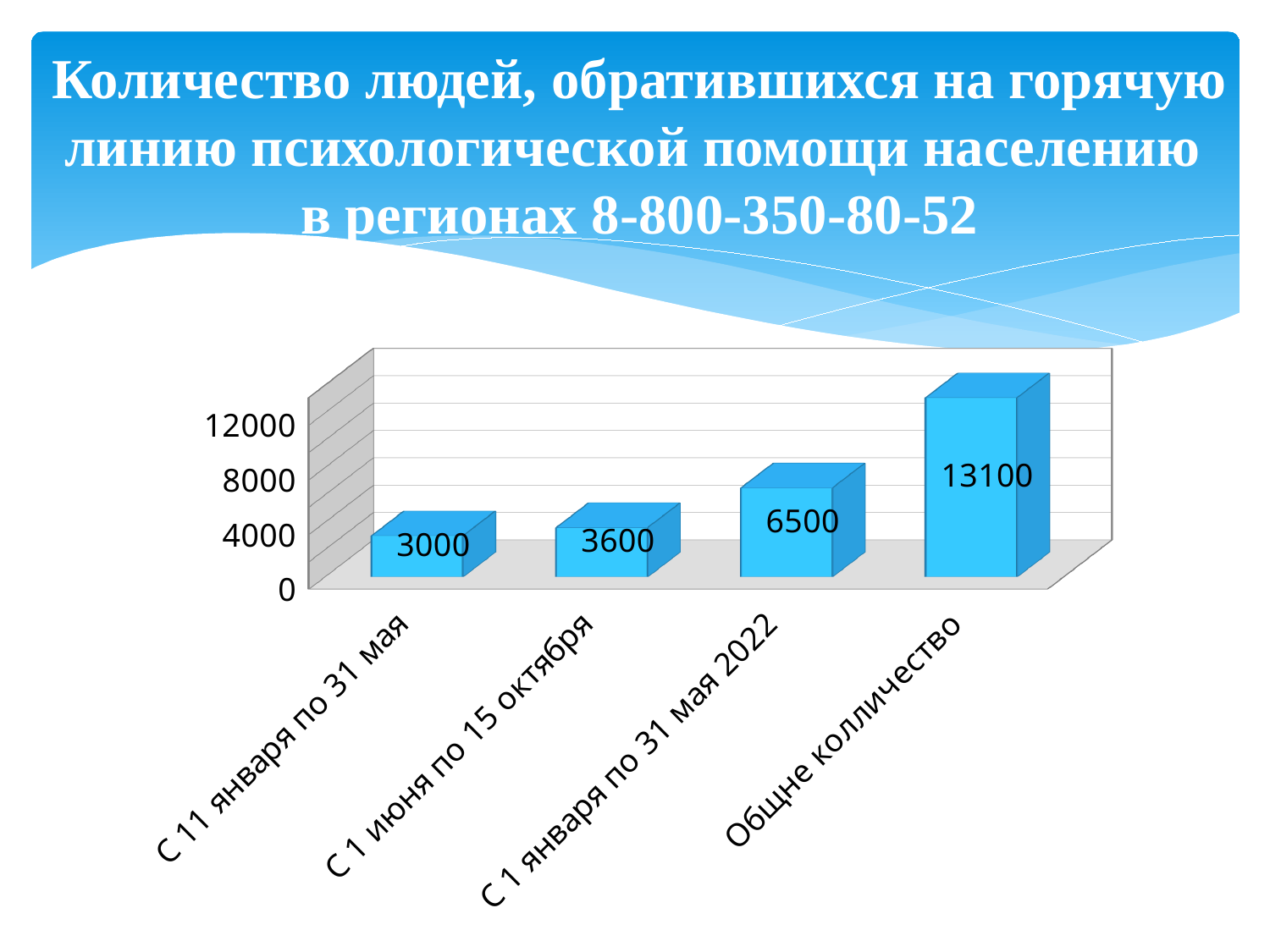
What is the value for the category "С 11 января по 31 мая"? 3000 What is the value for the category "С 1 января по 31 мая 2022"? 6500 What kind of chart is shown on the slide? bar chart Which is larger: the value for "С 1 июня по 15 октября" or the value for "С 11 января по 31 мая"? С 1 июня по 15 октября What is the value for the category "Общне колличество"? 13100 Do the values rise or fall from left to right along the x axis? rise How many categories are shown on the x axis? 4 Which category has the lowest value? С 11 января по 31 мая What is the value for the category "С 1 июня по 15 октября"? 3600 Which category has the highest value? Общне колличество What is the difference between the values for "С 1 января по 31 мая 2022" and "С 1 июня по 15 октября"? 2900 Is the value for "Общне колличество" greater or less than 12000? greater